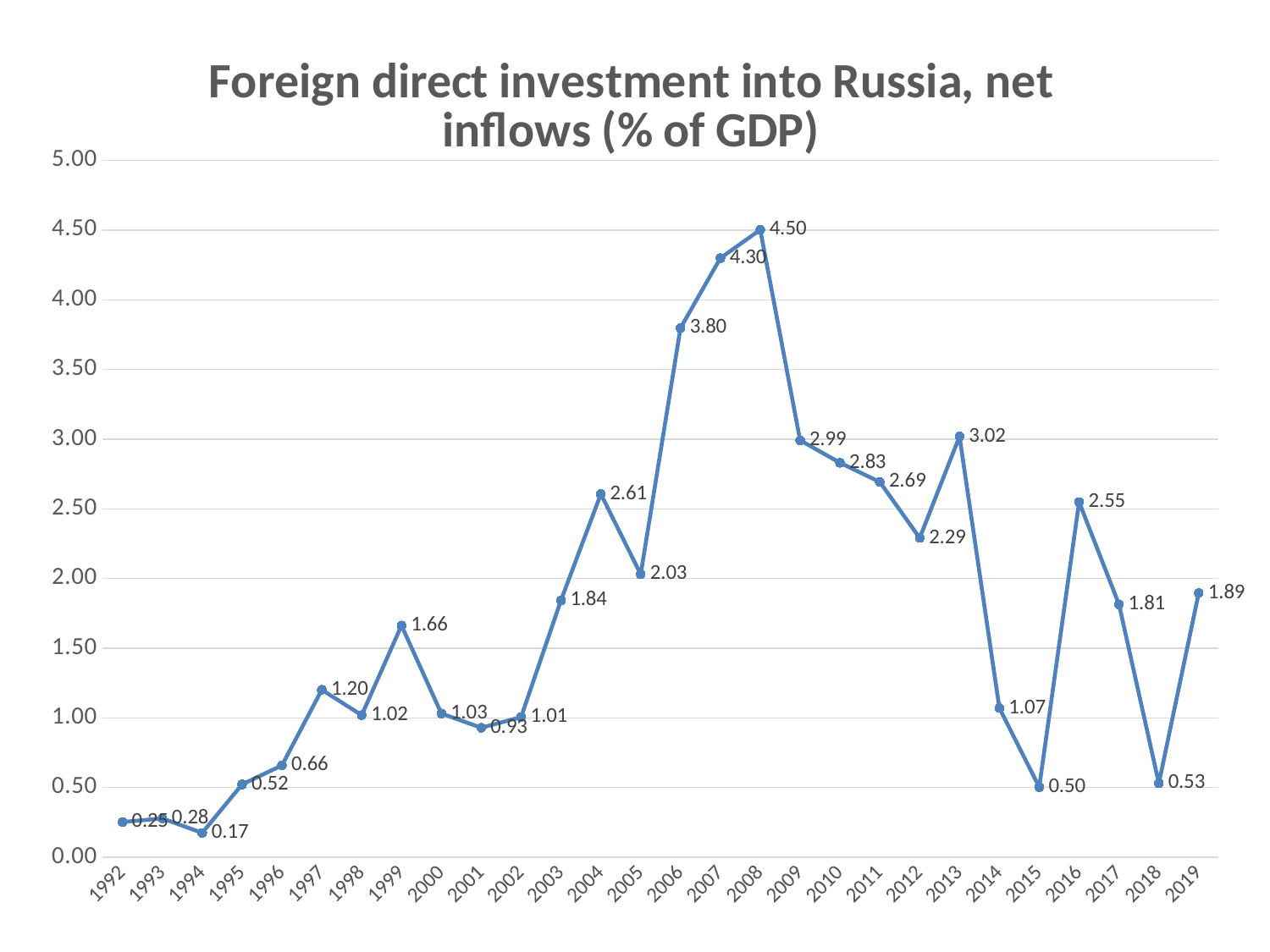
What is the difference between the values for 2016 and 2015? 2.05 How many years are plotted on the chart? 28 Which year has the highest value? 2008 Which year has the lowest value? 1994 Is the value for 2018 greater or less than 1.00? less What type of chart is shown on the slide? Line chart What is the value for 1999? 1.66 What is the difference between the values for 2008 and 2007? 0.20 What is the value for 2008? 4.50 What is the title of the chart? Foreign direct investment into Russia, net inflows (% of GDP) What is the value for 2013? 3.02 Which year has the larger value, 2006 or 2009? 2006